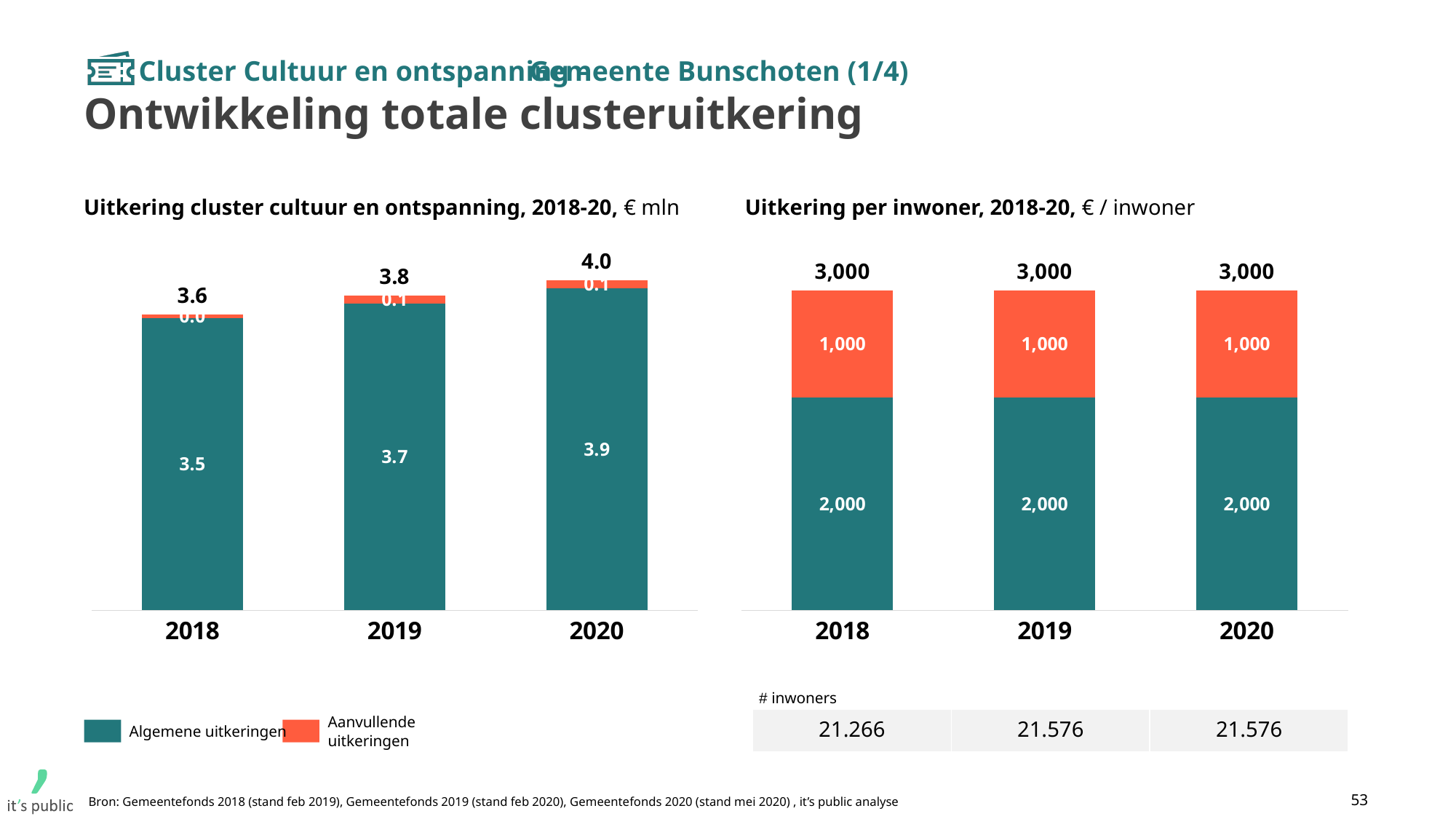
In the chart 'Uitkering cluster cultuur en ontspanning, 2018-20', what is the value for Aanvullende uitkeringen in 2018? 0.0 How many series does the legend list for the charts on this slide? 2 How many years are shown on the x axis of the chart 'Uitkering per inwoner, 2018-20'? 3 In the chart 'Uitkering cluster cultuur en ontspanning, 2018-20', which year has the highest total? 2020 In the chart 'Uitkering cluster cultuur en ontspanning, 2018-20', which year has the lowest value for Algemene uitkeringen? 2018 In the chart 'Uitkering per inwoner, 2018-20', what is the difference between Algemene uitkeringen and Aanvullende uitkeringen in 2018? 1,000 What kind of chart is 'Uitkering cluster cultuur en ontspanning, 2018-20'? stacked bar chart In the chart 'Uitkering cluster cultuur en ontspanning, 2018-20', what is the total labelled above the 2020 bar? 4.0 In the chart 'Uitkering per inwoner, 2018-20', what is the total for 2019? 3,000 In the chart 'Uitkering per inwoner, 2018-20', what is the value for Algemene uitkeringen in 2020? 2,000 In the chart 'Uitkering cluster cultuur en ontspanning, 2018-20', do the totals rise or fall from 2018 to 2020? rise In the chart 'Uitkering cluster cultuur en ontspanning, 2018-20', what is the value for Algemene uitkeringen in 2019? 3.7